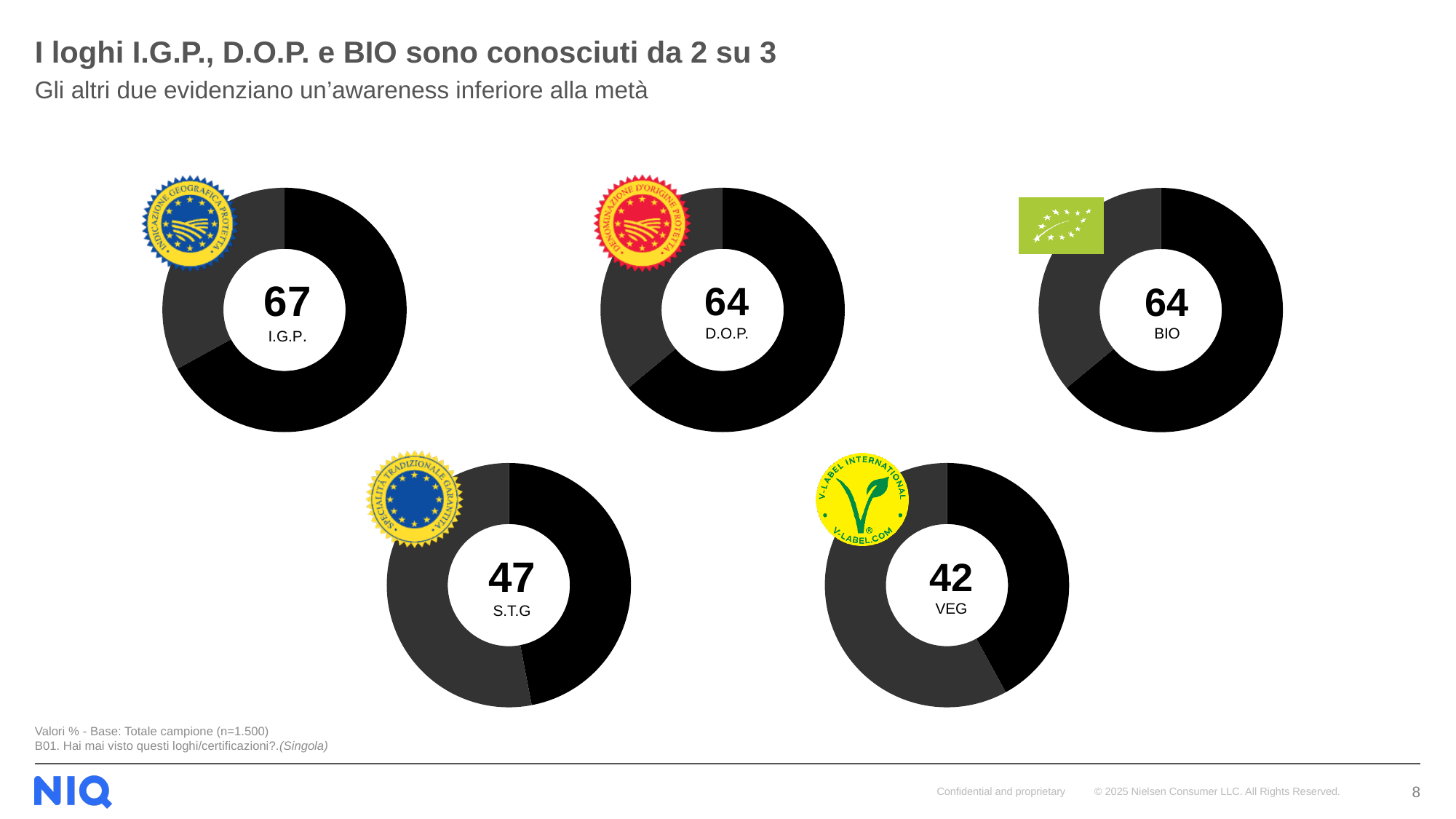
Which logo has the lowest awareness value among the five donut charts? VEG Which is larger, the value for S.T.G or the value for VEG? S.T.G What value is shown in the centre of the S.T.G donut chart? 47 What value is shown in the centre of the D.O.P. donut chart? 64 Which logo has the highest awareness value among the five donut charts? I.G.P. What is the difference between the D.O.P. value and the S.T.G value? 17 What value is shown in the centre of the I.G.P. donut chart? 67 Which two logos share the same value of 64? D.O.P. and BIO What value is shown in the centre of the VEG donut chart? 42 How many donut charts are shown on the slide? 5 What kind of chart is used to show each logo's awareness value? Donut chart What is the difference between the I.G.P. value and the VEG value? 25